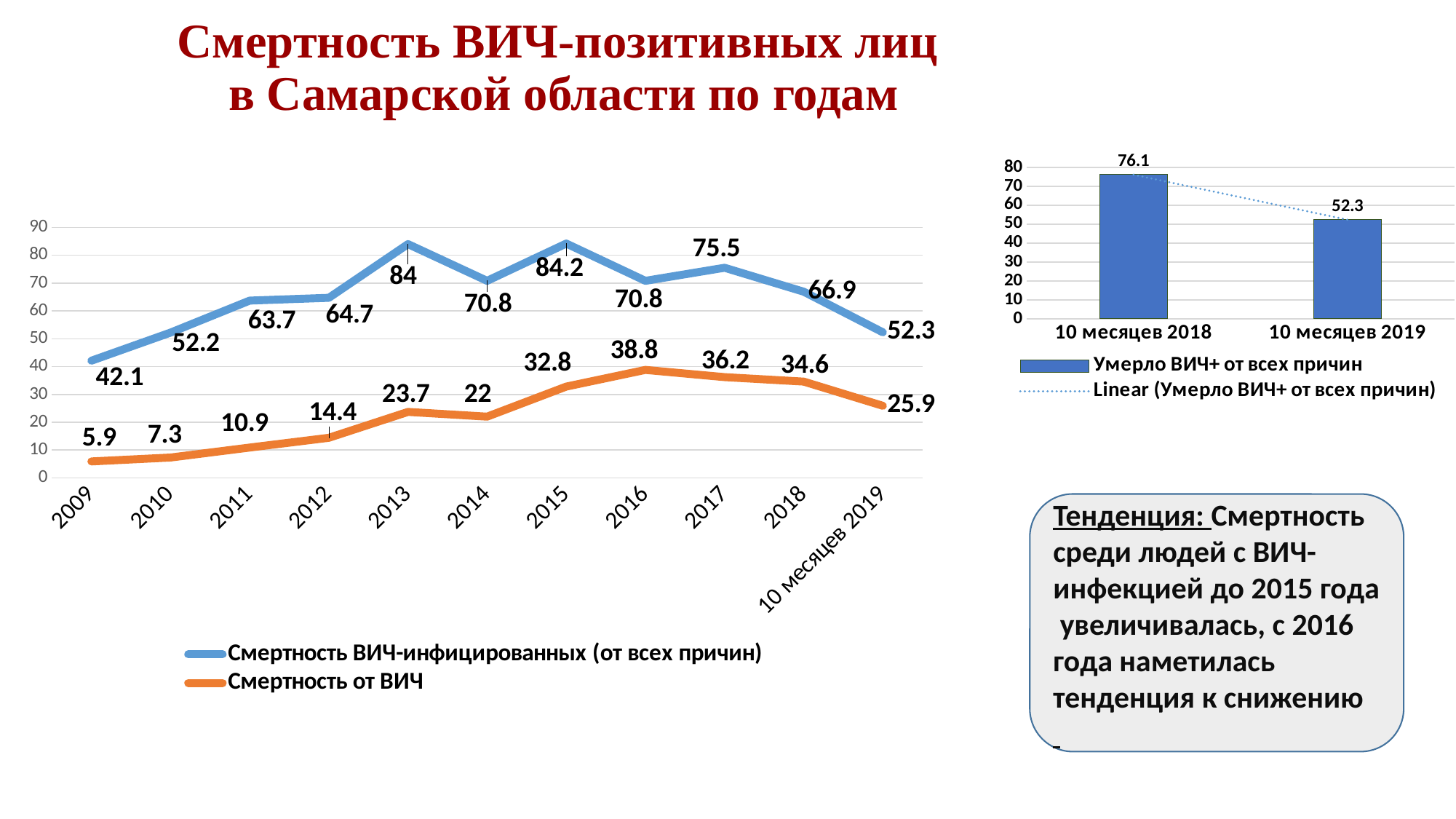
In the line chart on the left, what is the difference between the 'Смертность от ВИЧ' values for 2016 and 2015? 6 How many points along the x axis does the line chart on the left have? 11 How many series does the legend of the line chart on the left list? 2 In the line chart on the left, which year has the highest value for 'Смертность ВИЧ-инфицированных (от всех причин)'? 2015 In the bar chart on the right, what is the difference between the values for '10 месяцев 2018' and '10 месяцев 2019'? 23.8 In the line chart on the left, which is larger: the 'Смертность ВИЧ-инфицированных (от всех причин)' value for 2013 or for 2014? 2013 In the line chart on the left, which year has the lowest value for 'Смертность от ВИЧ'? 2009 In the line chart on the left, what is the value of 'Смертность ВИЧ-инфицированных (от всех причин)' for 2017? 75.5 In the bar chart on the right, what is the value for '10 месяцев 2019'? 52.3 In the line chart on the left, does the 'Смертность от ВИЧ' series rise or fall from 2009 to 2013? rise In the line chart on the left, what is the value of the series 'Смертность от ВИЧ' for 2013? 23.7 What kind of chart is the chart on the right of the slide? bar chart